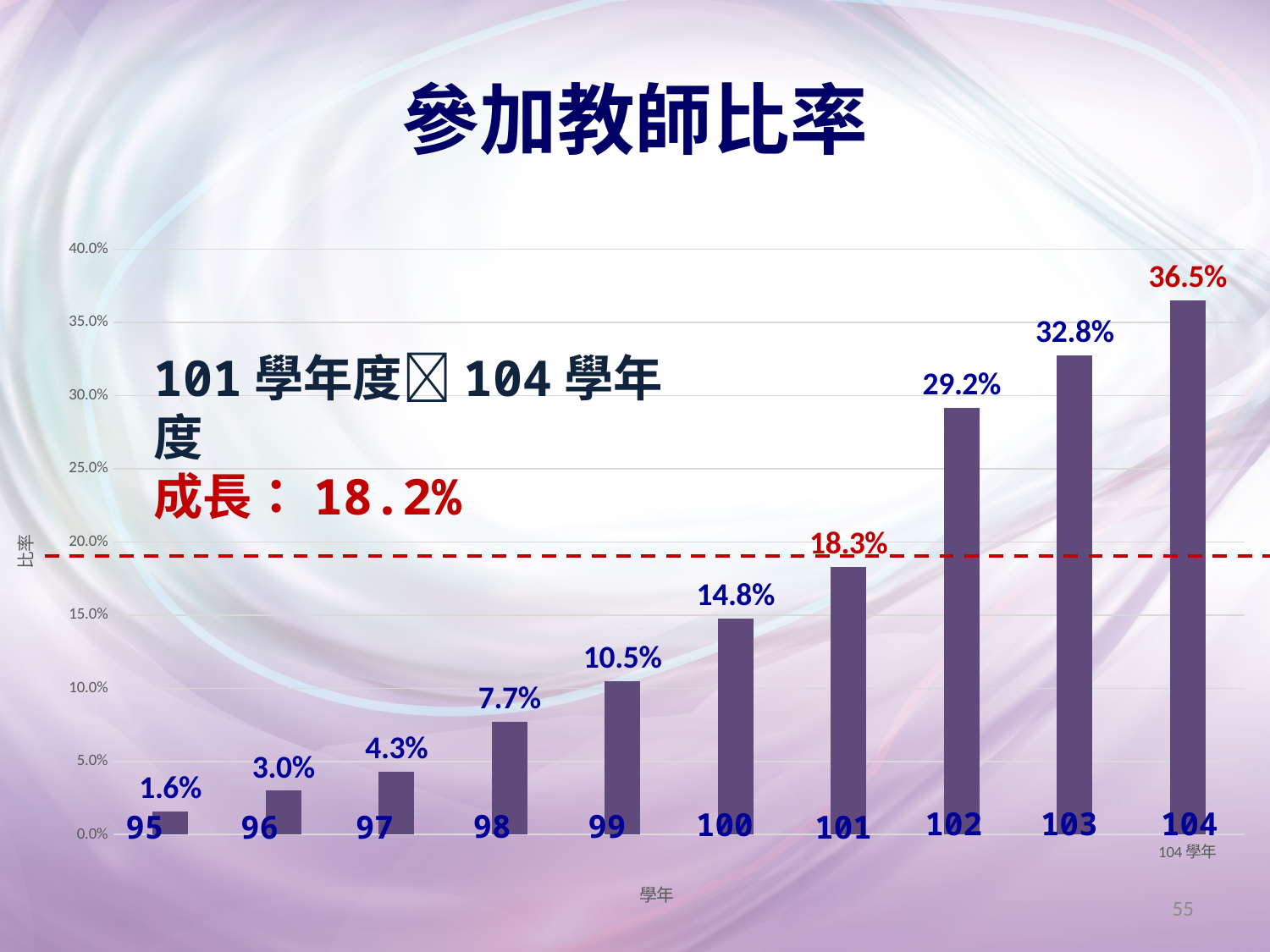
What kind of chart is shown on the slide? bar chart Is the value for 102 學年 greater or less than 25.0%? greater What is the difference between the values for 100 and 99 學年? 4.3% Do the values rise or fall from 95 to 104 學年? rise Which 學年 has the lowest 參加教師比率? 95 What is the value for 98 學年? 7.7% What is the value for 104 學年? 36.5% How many 學年 categories are shown on the x axis? 10 What is the value for 101 學年? 18.3% What is the difference between the values for 104 and 101 學年? 18.2% Which is larger, the value for 102 or the value for 103 學年? 103 Which 學年 has the highest 參加教師比率? 104